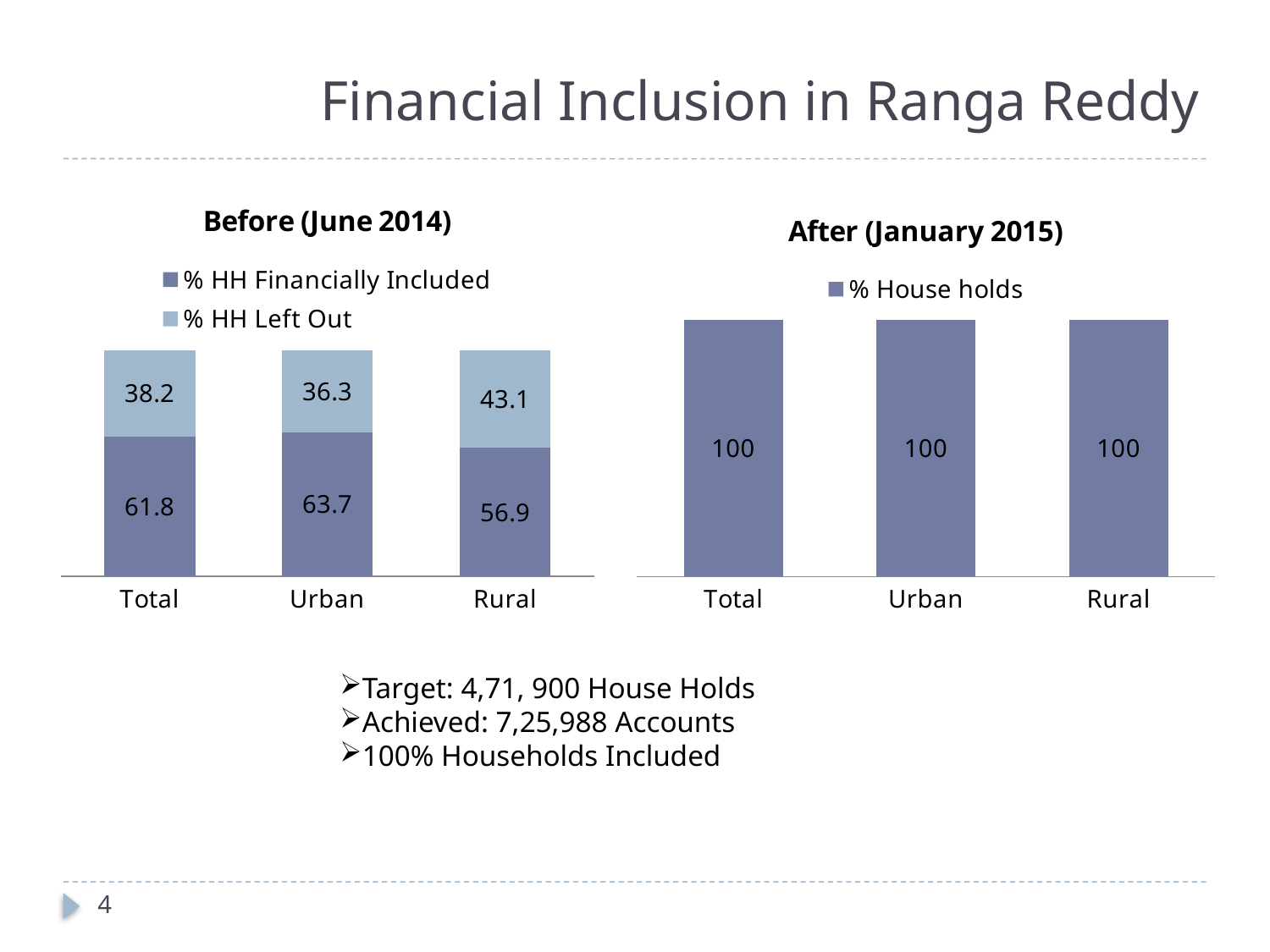
In the 'Before (June 2014)' chart, what is the total of the stacked bar for Urban? 100 In the 'Before (June 2014)' chart, what is the value of '% HH Financially Included' for Total? 61.8 What kind of chart is the 'After (January 2015)' chart? Bar chart In the 'Before (June 2014)' chart, what is the difference between the '% HH Financially Included' values for Urban and Rural? 6.8 In the 'Before (June 2014)' chart, what is the value of '% HH Financially Included' for Urban? 63.7 In the 'Before (June 2014)' chart, what is the value of '% HH Left Out' for Rural? 43.1 In the 'Before (June 2014)' chart, which category has the highest '% HH Left Out' value? Rural In the 'Before (June 2014)' chart, which category has the lowest '% HH Financially Included' value? Rural In the 'Before (June 2014)' chart, is the '% HH Left Out' value larger for Total or for Urban? Total In the 'After (January 2015)' chart, what is the '% House holds' value for Rural? 100 How many series does the legend of the 'Before (June 2014)' chart list? 2 How many categories are shown on the x axis of the 'After (January 2015)' chart? 3